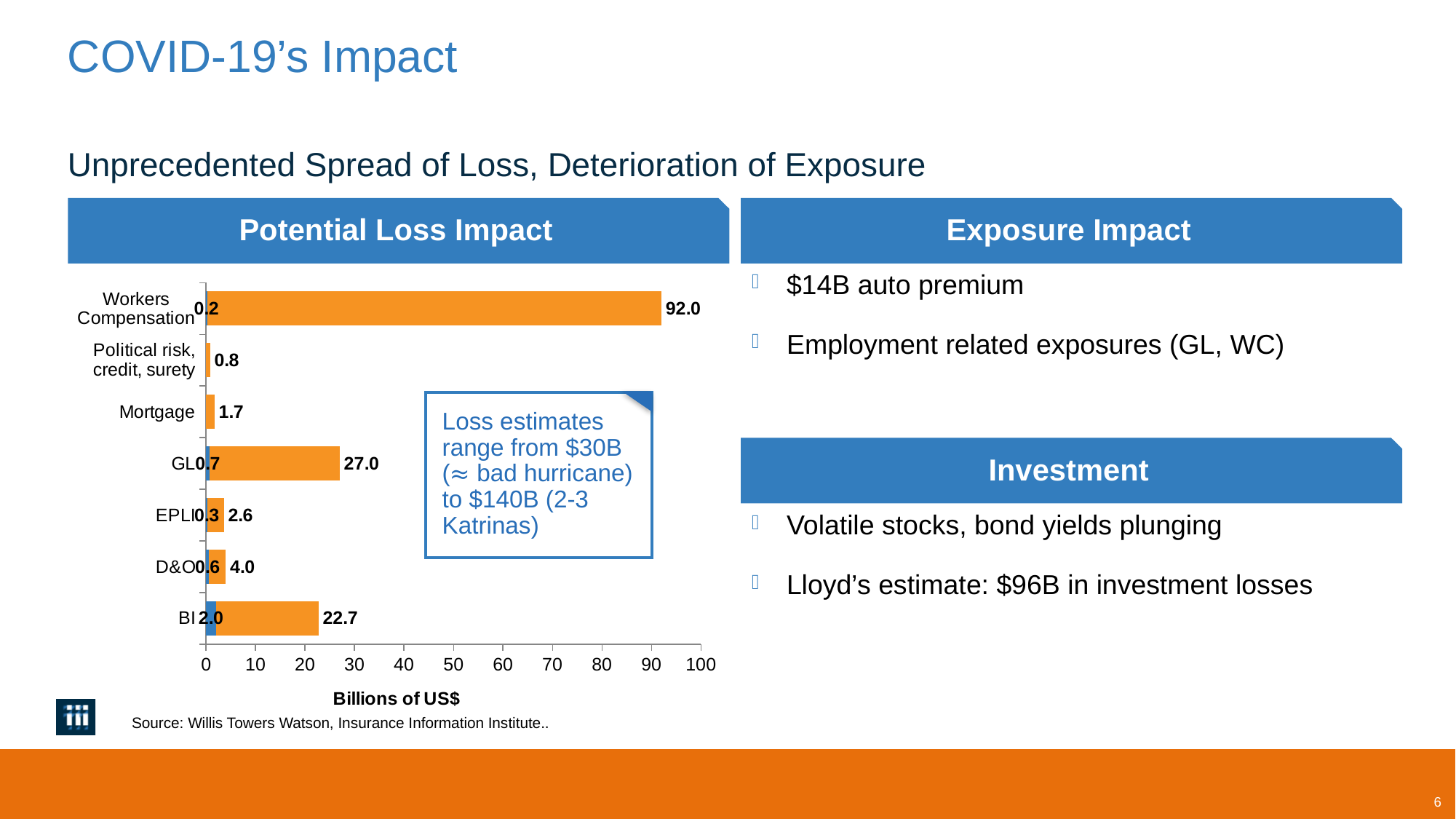
What is the x-axis title of the Potential Loss Impact chart? Billions of US$ What value is shown for Mortgage in the Potential Loss Impact chart? 1.7 What type of chart is the Potential Loss Impact chart? Bar chart Which category has the highest orange bar value in the Potential Loss Impact chart? Workers Compensation What is the larger (orange) value shown for Workers Compensation in the Potential Loss Impact chart? 92.0 What is the larger (orange) value shown for GL in the Potential Loss Impact chart? 27.0 What is the smaller (blue) value shown for BI in the Potential Loss Impact chart? 2.0 Which category has the lowest orange bar value in the Potential Loss Impact chart? Political risk, credit, surety In the Potential Loss Impact chart, which has a larger orange value, D&O or EPLI? D&O How many categories are shown in the Potential Loss Impact chart? 7 In the Potential Loss Impact chart, what is the difference between the orange values for GL and BI? 4.3 What is the larger (orange) value shown for BI in the Potential Loss Impact chart? 22.7